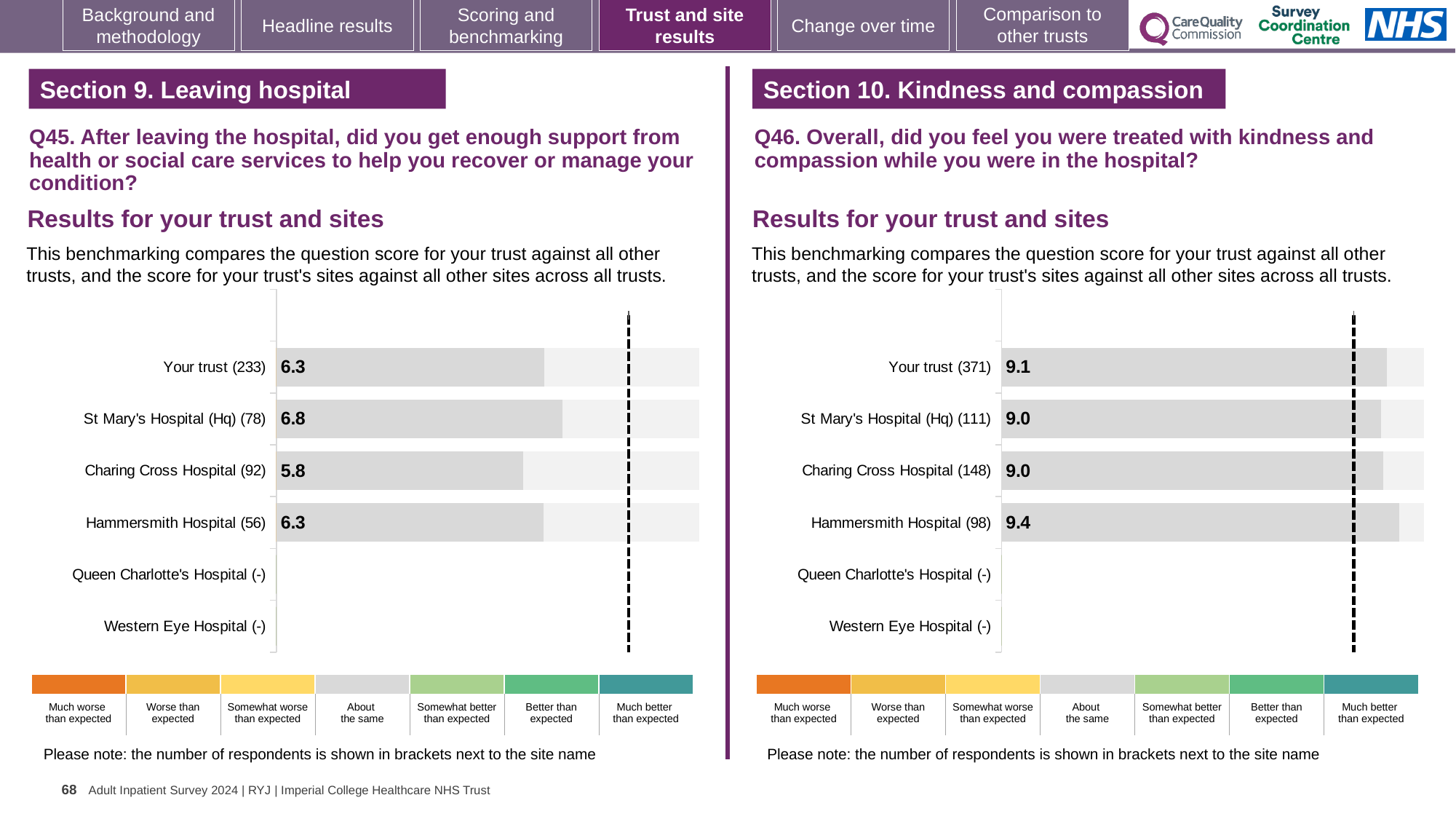
In the Q46 chart on the right, what is the score for Your trust? 9.1 In the Q45 chart on the left, which site has the lowest score? Charing Cross Hospital In the Q45 chart on the left, what is the score for St Mary's Hospital (Hq)? 6.8 In the Q46 chart on the right, which site has the highest score? Hammersmith Hospital In the Q45 chart on the left, how many sites or trust rows have a score printed? 4 In the Q46 chart on the right, which is larger: the score for Hammersmith Hospital or the score for Your trust? Hammersmith Hospital In the Q45 chart on the left, what is the difference between the scores for St Mary's Hospital (Hq) and Charing Cross Hospital? 1.0 In the Q46 chart on the right, what is the difference between the scores for Hammersmith Hospital and St Mary's Hospital (Hq)? 0.4 In the Q45 chart on the left, what is the score for Charing Cross Hospital? 5.8 What kind of chart is used in the Q46 chart on the right? Bar chart In the Q46 chart on the right, what is the score for Hammersmith Hospital? 9.4 In the Q45 chart on the left, which site has the highest score? St Mary's Hospital (Hq)